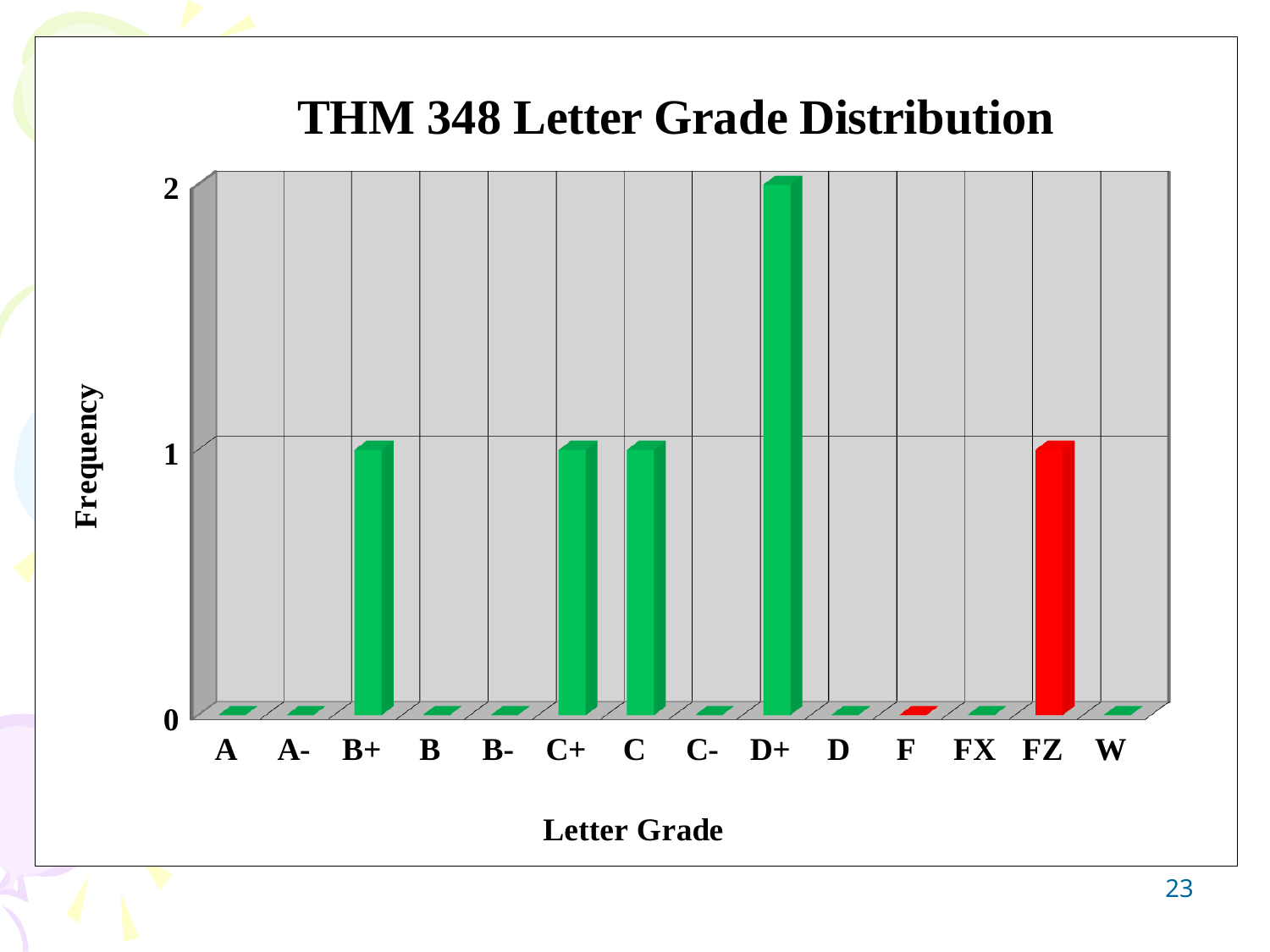
What is the difference in frequency between D+ and C? 1 What is the title of the chart? THM 348 Letter Grade Distribution What is the label of the y axis? Frequency How many letter grade categories are shown on the x axis? 14 Which letter grade's bar is coloured red? FZ What is the frequency for B+? 1 What kind of chart is shown on the slide? Bar chart Which letter grade has the highest frequency? D+ What is the frequency for A? 0 What is the frequency for D+? 2 What is the frequency for FZ? 1 Which has a higher frequency, C+ or C-? C+